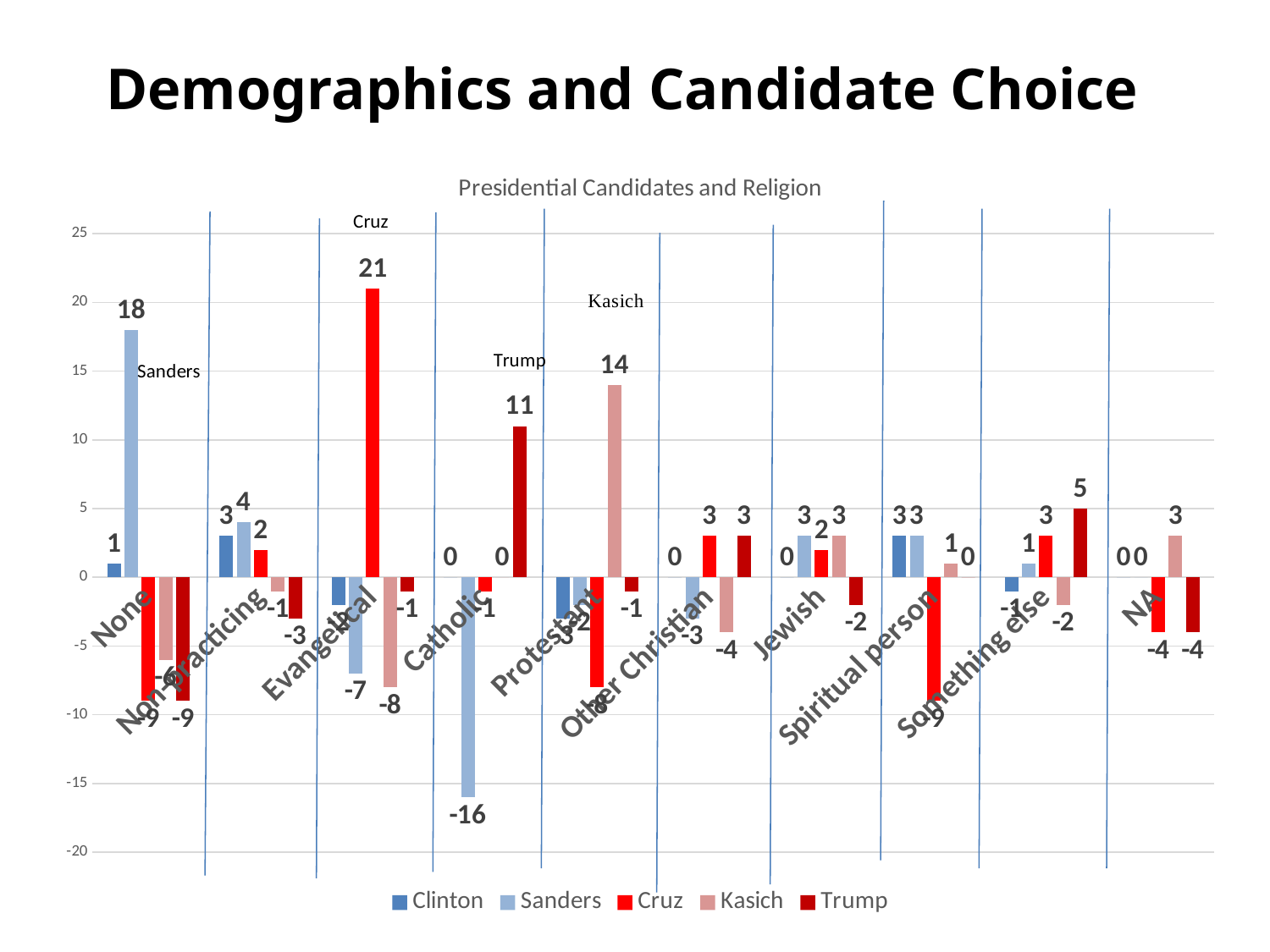
What is the difference between Cruz's value for Evangelical and Sanders's value for None? 3 What is the value for Sanders in the Catholic category? -16 Which is larger: Kasich's value for Protestant or Trump's value for Catholic? Kasich's value for Protestant Which candidate has the highest value in the Catholic category? Trump How many series does the legend list? 5 Which candidate has the lowest value in the Evangelical category? Kasich What is the value for Trump in the Something else category? 5 What type of chart is shown? Bar chart What is the value for Cruz in the Evangelical category? 21 What is the value for Sanders in the None category? 18 What is the value for Kasich in the Protestant category? 14 How many religion categories are shown on the x axis? 10